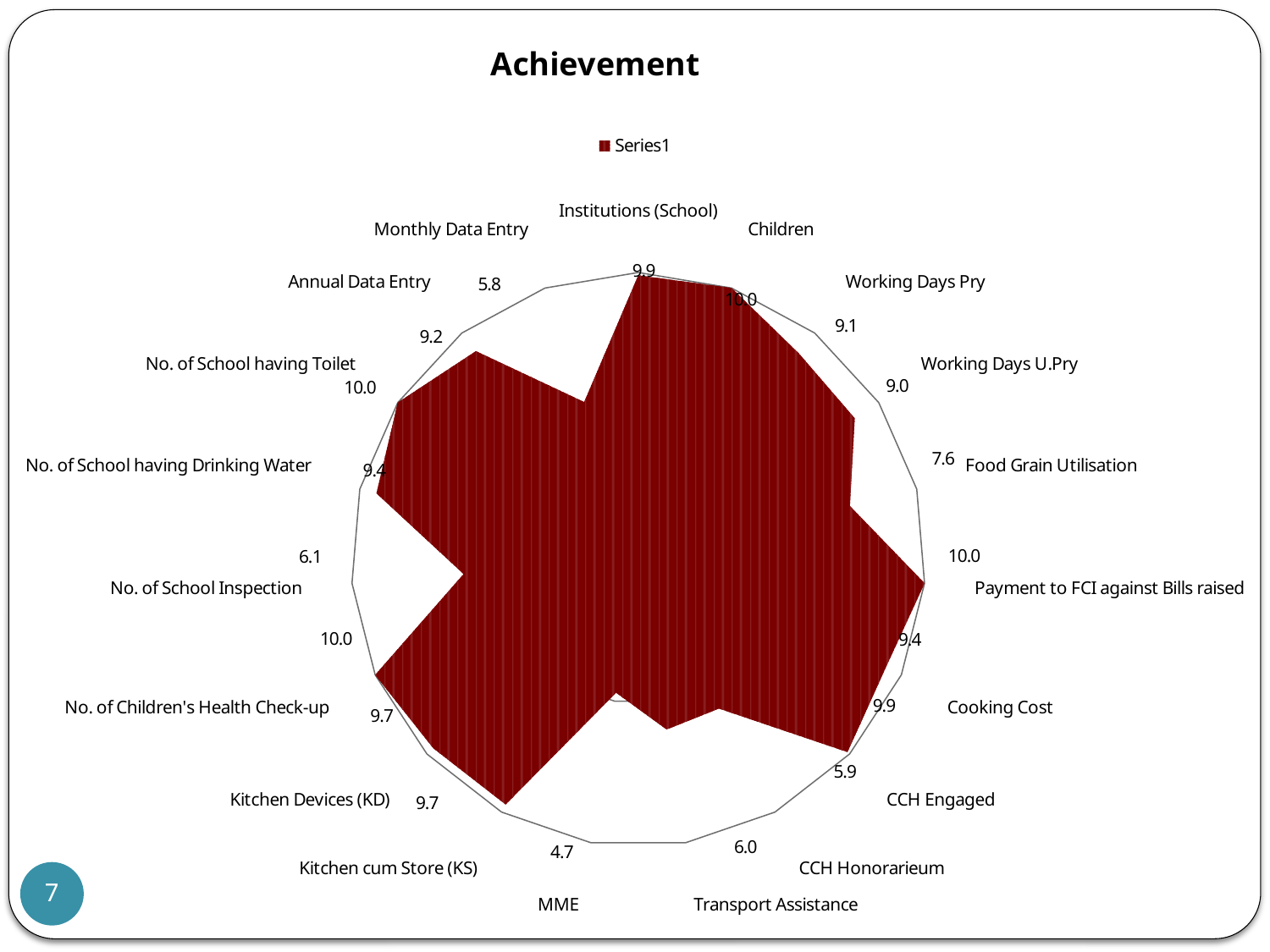
What is the value for MME? 4.7 What is the difference between the values for Payment to FCI against Bills raised and CCH Honorarieum? 4.1 How many series does the legend list? 1 What is the value for Kitchen Devices (KD)? 9.7 What is the value for Monthly Data Entry? 5.8 What kind of chart is shown on the slide? Radar chart Which is larger, the value for Annual Data Entry or the value for Monthly Data Entry? Annual Data Entry Which is larger, the value for Working Days Pry or the value for Food Grain Utilisation? Working Days Pry What is the value for No. of School Inspection? 6.1 Which category has the lowest value? MME How many categories are plotted on the chart? 19 What is the value for Food Grain Utilisation? 7.6